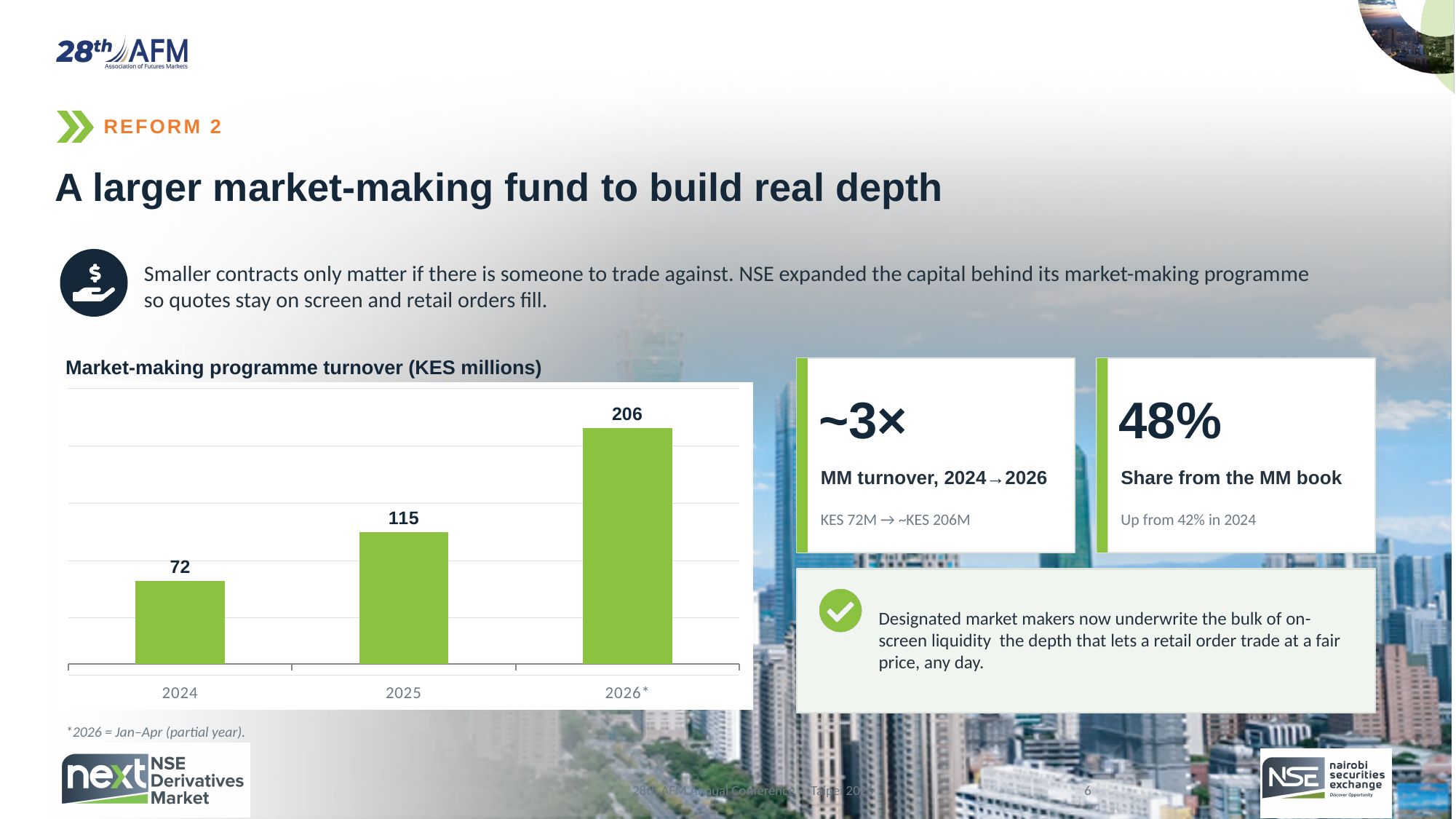
What is the difference in turnover between 2026* and 2024? 134 What is the market-making programme turnover for 2025? 115 How many years are shown on the chart? 3 What kind of chart is used to show market-making programme turnover? Bar chart Which year has the larger turnover, 2025 or 2026*? 2026* What is the title of the chart? Market-making programme turnover (KES millions) Which year has the lowest market-making programme turnover? 2024 Do the turnover values rise or fall from 2024 to 2026*? Rise What is the market-making programme turnover for 2026*? 206 What is the market-making programme turnover for 2024? 72 Which year has the highest market-making programme turnover? 2026* What is the difference in turnover between 2025 and 2024? 43